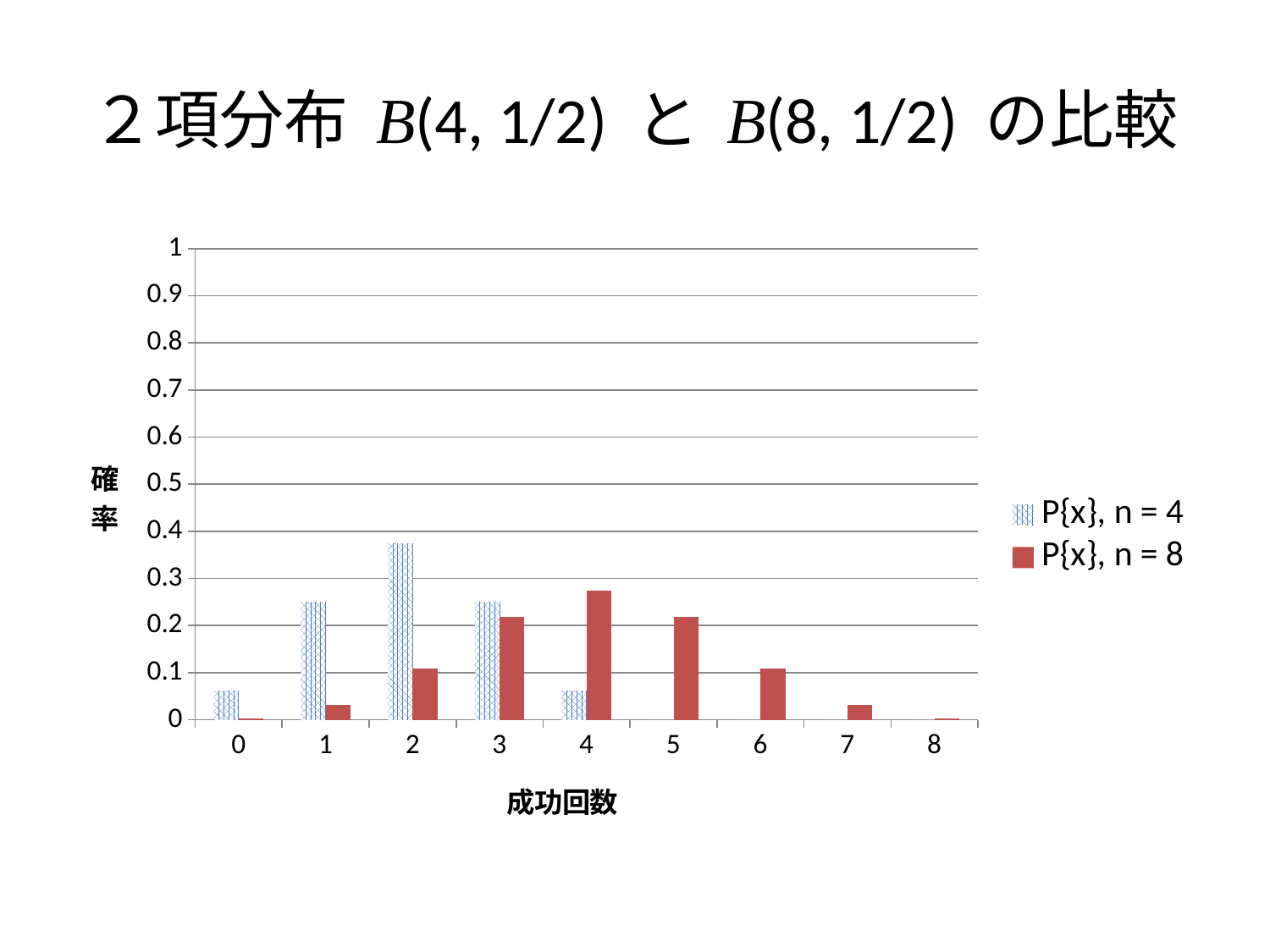
Is the value for P{x}, n = 4 at 成功回数 = 2 greater or less than 0.3? greater For the series P{x}, n = 8, do the values rise or fall as 成功回数 goes from 4 to 8? fall For the series P{x}, n = 4, at which number of successes (成功回数) is the probability highest? 2 For the series P{x}, n = 8, at which number of successes (成功回数) is the probability highest? 4 What is the label of the x axis? 成功回数 How many series does the legend list? 2 Is the value for P{x}, n = 8 at 成功回数 = 4 greater or less than 0.3? less Is the value for P{x}, n = 8 at 成功回数 = 1 greater or less than 0.1? less How many categories are shown on the x axis (成功回数)? 9 What kind of chart is shown on the slide? bar chart At 成功回数 = 2, which series has the larger value, P{x}, n = 4 or P{x}, n = 8? P{x}, n = 4